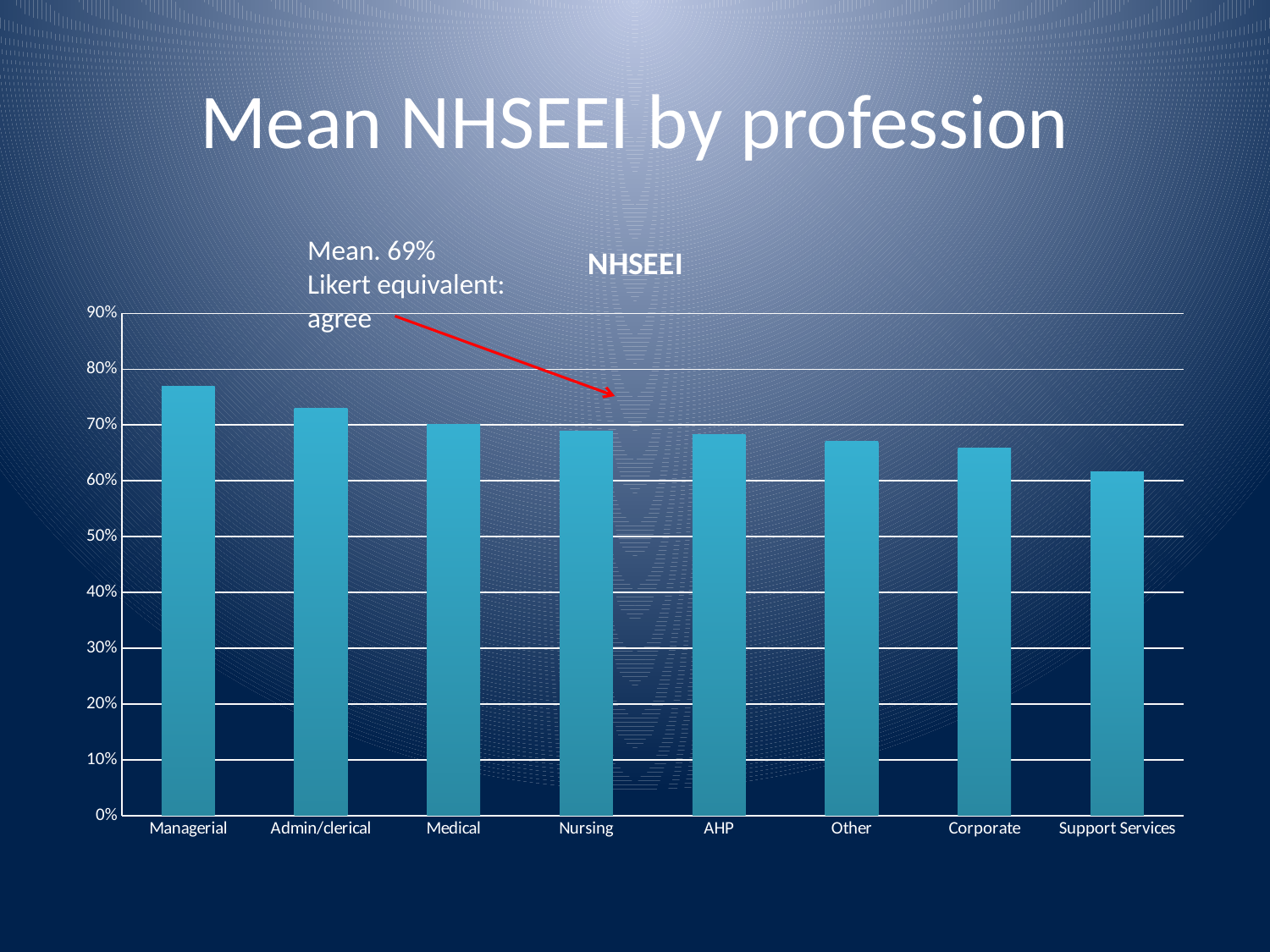
Is the value for Corporate greater or less than 70%? less Which profession has the lowest mean NHSEEI? Support Services Which is larger, the value for Managerial or the value for Support Services? Managerial Do the values rise or fall moving from left to right along the x axis? fall Is the value for Support Services greater or less than 60%? greater Which profession has the highest mean NHSEEI? Managerial How many professions are shown on the x axis of the chart? 8 What mean value is stated in the annotation on the chart? 69% Is the value for Managerial greater or less than 70%? greater What kind of chart is shown on the slide? bar chart Which is larger, the value for Admin/clerical or the value for Corporate? Admin/clerical What is the title shown above the chart? NHSEEI